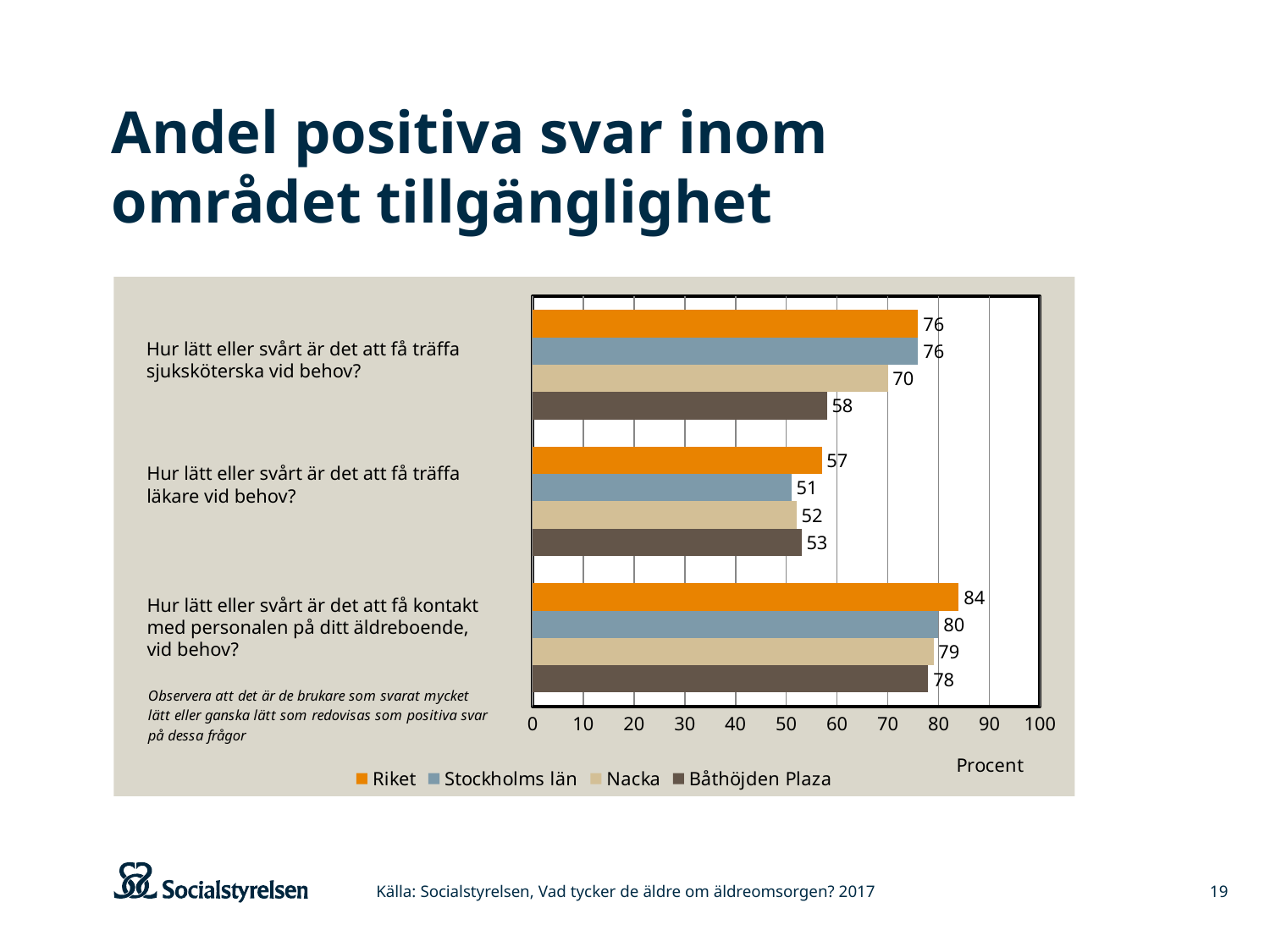
What kind of chart is shown on the slide? Bar chart How many series does the legend list? 4 Which is larger on the question about meeting a doctor when needed: the value for Riket or the value for Stockholms län? Riket What is the value for Nacka on the question about meeting a doctor when needed ("Hur lätt eller svårt är det att få träffa läkare vid behov?")? 52 What is the difference between Riket and Båthöjden Plaza on the question about meeting a nurse when needed? 18 Which series has the highest value on the question about contacting staff at the care home? Riket What is the value for Båthöjden Plaza on the question about meeting a nurse when needed ("Hur lätt eller svårt är det att få träffa sjuksköterska vid behov?")? 58 How many question categories are shown on the chart? 3 What is the value for Stockholms län on the question about contacting staff at the care home ("Hur lätt eller svårt är det att få kontakt med personalen på ditt äldreboende, vid behov?")? 80 What unit label is shown below the horizontal axis of the chart? Procent Which series has the lowest value on the question about meeting a nurse when needed? Båthöjden Plaza What is the value for Riket on the question about meeting a nurse when needed ("Hur lätt eller svårt är det att få träffa sjuksköterska vid behov?")? 76